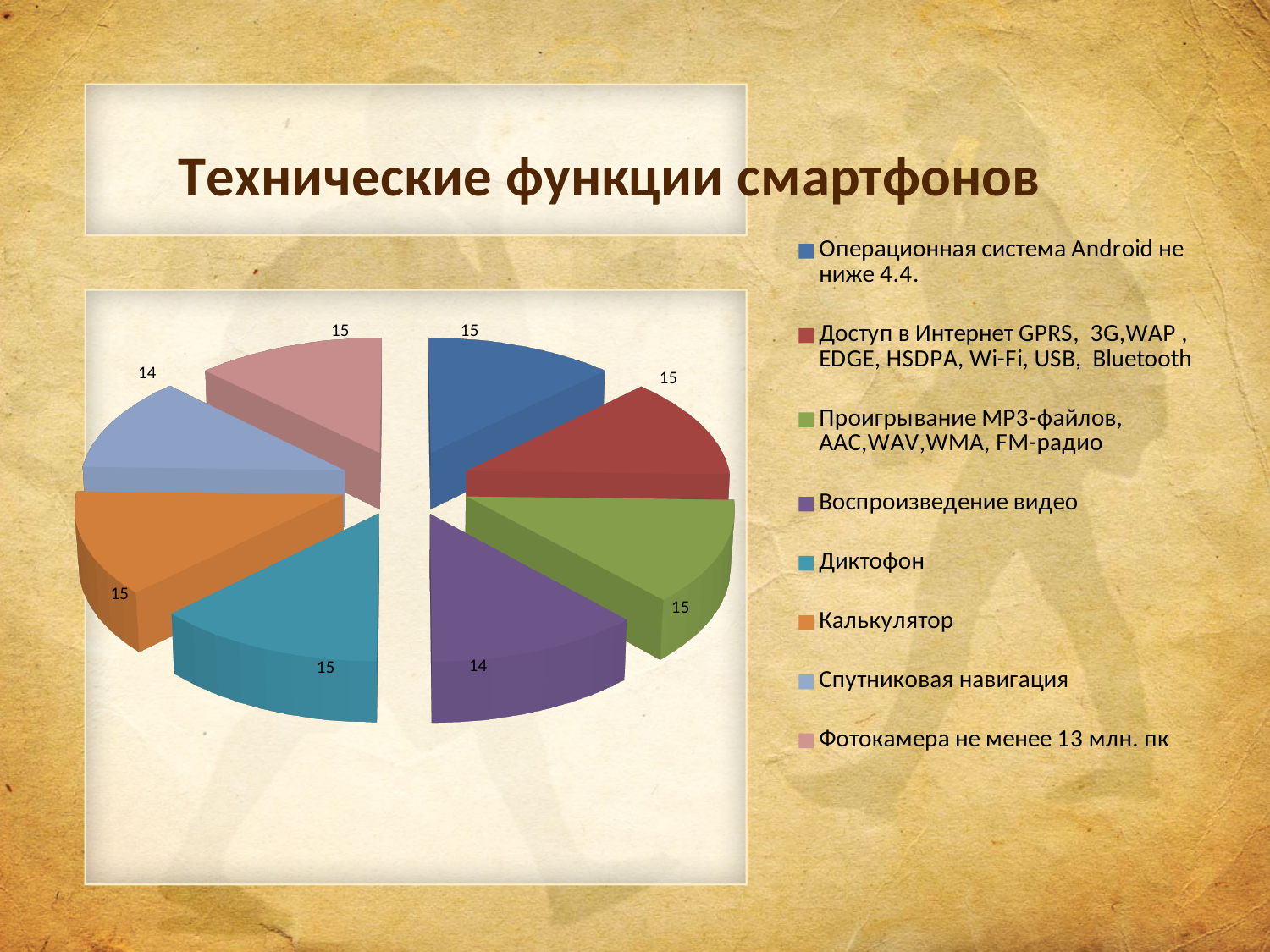
What kind of chart is shown on the slide? Pie chart Which is larger, the value for "Диктофон" or the value for "Воспроизведение видео"? Диктофон What is the value for "Воспроизведение видео"? 14 How many slices does the pie chart have? 8 What is the value for "Фотокамера не менее 13 млн. пк"? 15 What is the title of the chart on the slide? Технические функции смартфонов How many slices of the pie chart have a value of 14? 2 How many entries does the legend list? 8 What is the difference between the value for "Проигрывание MP3-файлов, AAC,WAV,WMA, FM-радио" and the value for "Спутниковая навигация"? 1 What is the value for "Спутниковая навигация"? 14 What is the value for "Калькулятор"? 15 What is the value for "Операционная система Android не ниже 4.4."? 15